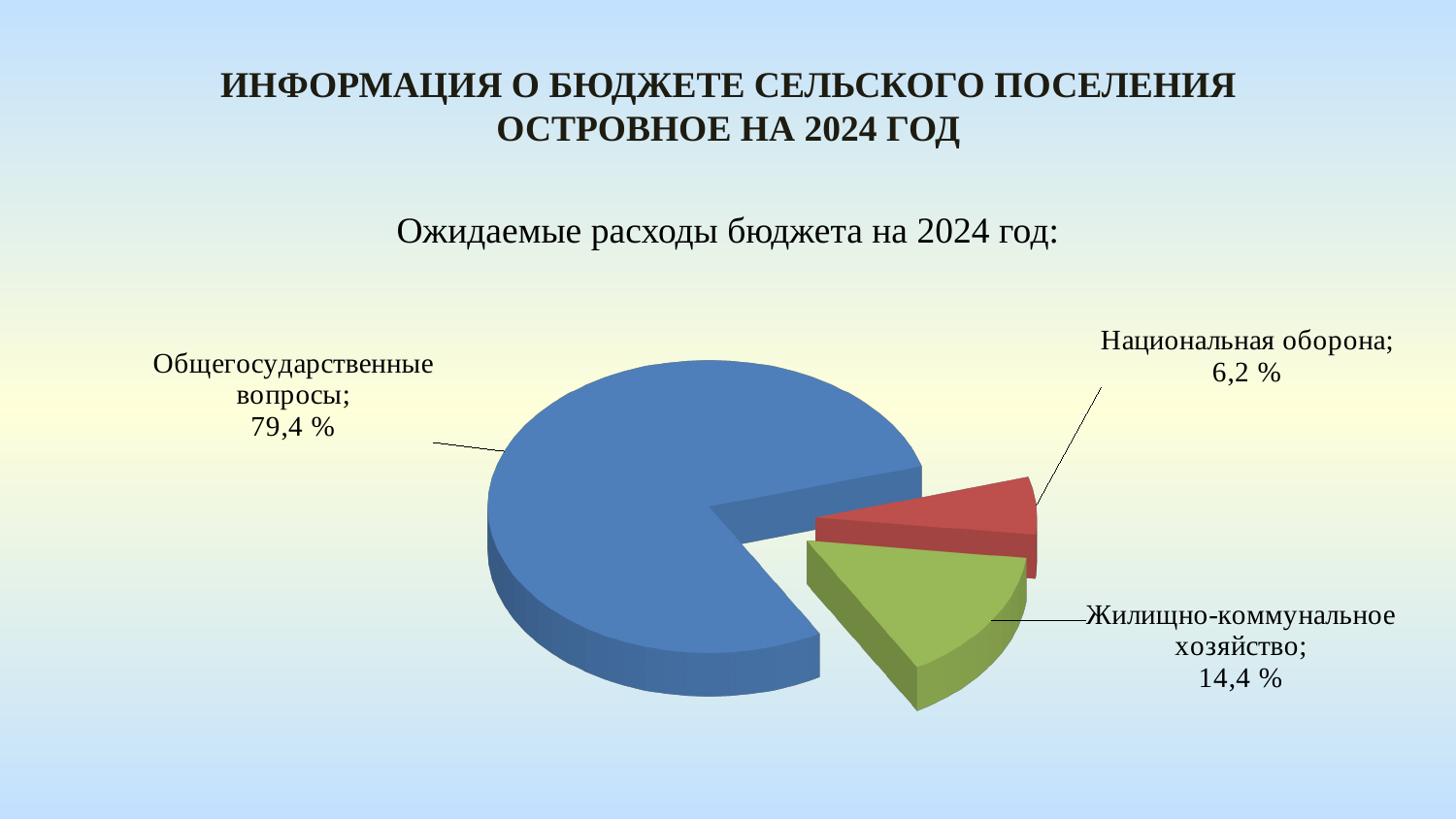
How many categories are shown in the pie chart? 3 What is the difference between the shares of Жилищно-коммунальное хозяйство and Национальная оборона? 8,2 % What share of the pie does Общегосударственные вопросы have? 79,4 % What is the value shown for Жилищно-коммунальное хозяйство? 14,4 % What kind of chart is shown on the slide? Pie chart What is the subtitle above the chart? Ожидаемые расходы бюджета на 2024 год: What is the difference between the shares of Общегосударственные вопросы and Жилищно-коммунальное хозяйство? 65,0 % Which is larger: Жилищно-коммунальное хозяйство or Национальная оборона? Жилищно-коммунальное хозяйство Which category has the smallest slice of the pie? Национальная оборона Which category has the largest slice of the pie? Общегосударственные вопросы What is the value shown for Национальная оборона? 6,2 % What colour is the slice for Национальная оборона? Red